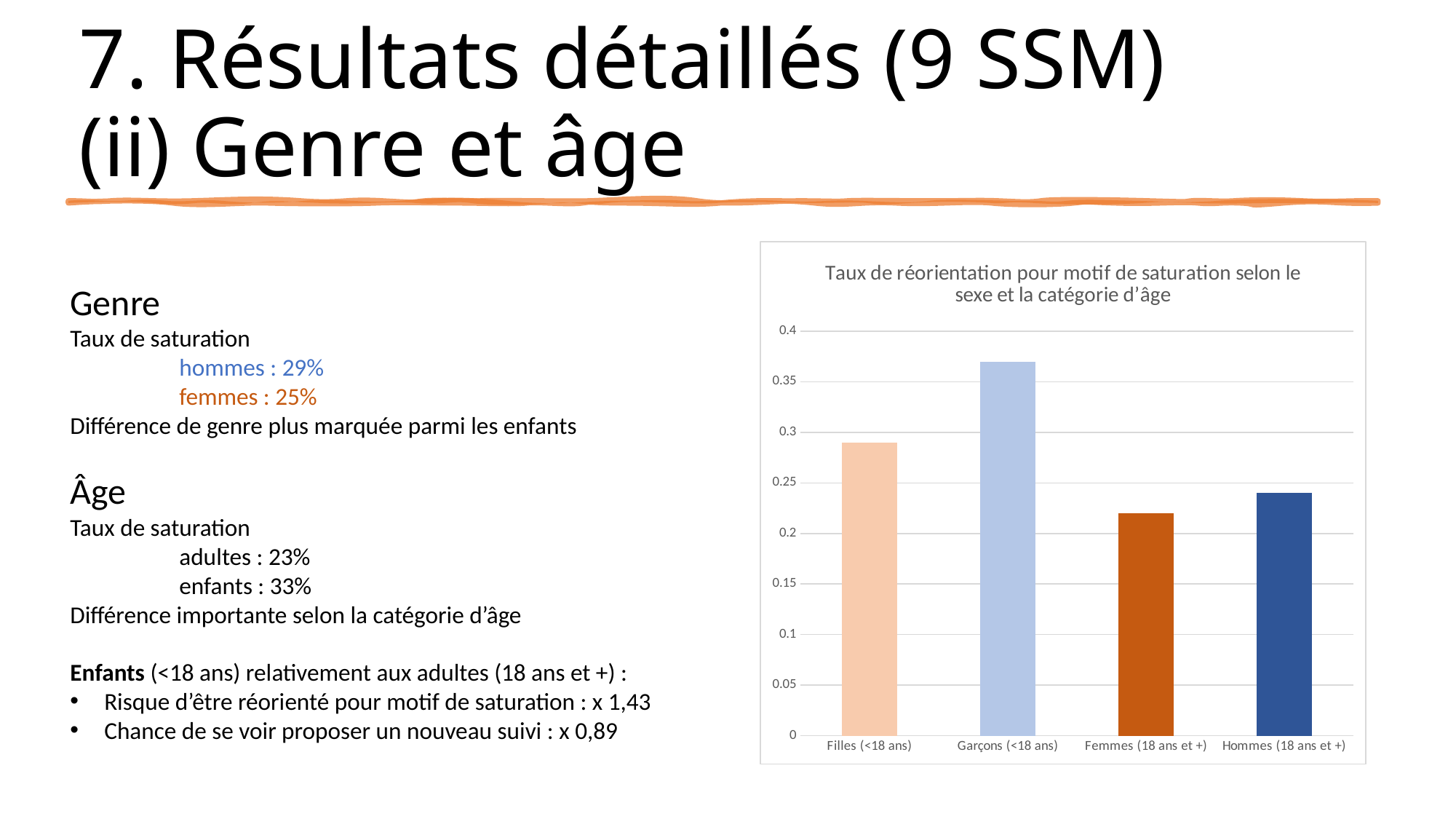
Which category has the highest bar in the chart? Garçons (<18 ans) Is the value for Garçons (<18 ans) greater or less than 0.35? greater What is the title of the chart? Taux de réorientation pour motif de saturation selon le sexe et la catégorie d'âge Is the value for Hommes (18 ans et +) greater or less than 0.25? less How many categories are shown on the x axis of the chart? 4 What kind of chart is shown on the slide? bar chart Is the value for Femmes (18 ans et +) greater or less than 0.25? less Which is larger, the value for Garçons (<18 ans) or the value for Filles (<18 ans)? Garçons (<18 ans) Which is larger, the value for Filles (<18 ans) or the value for Hommes (18 ans et +)? Filles (<18 ans)